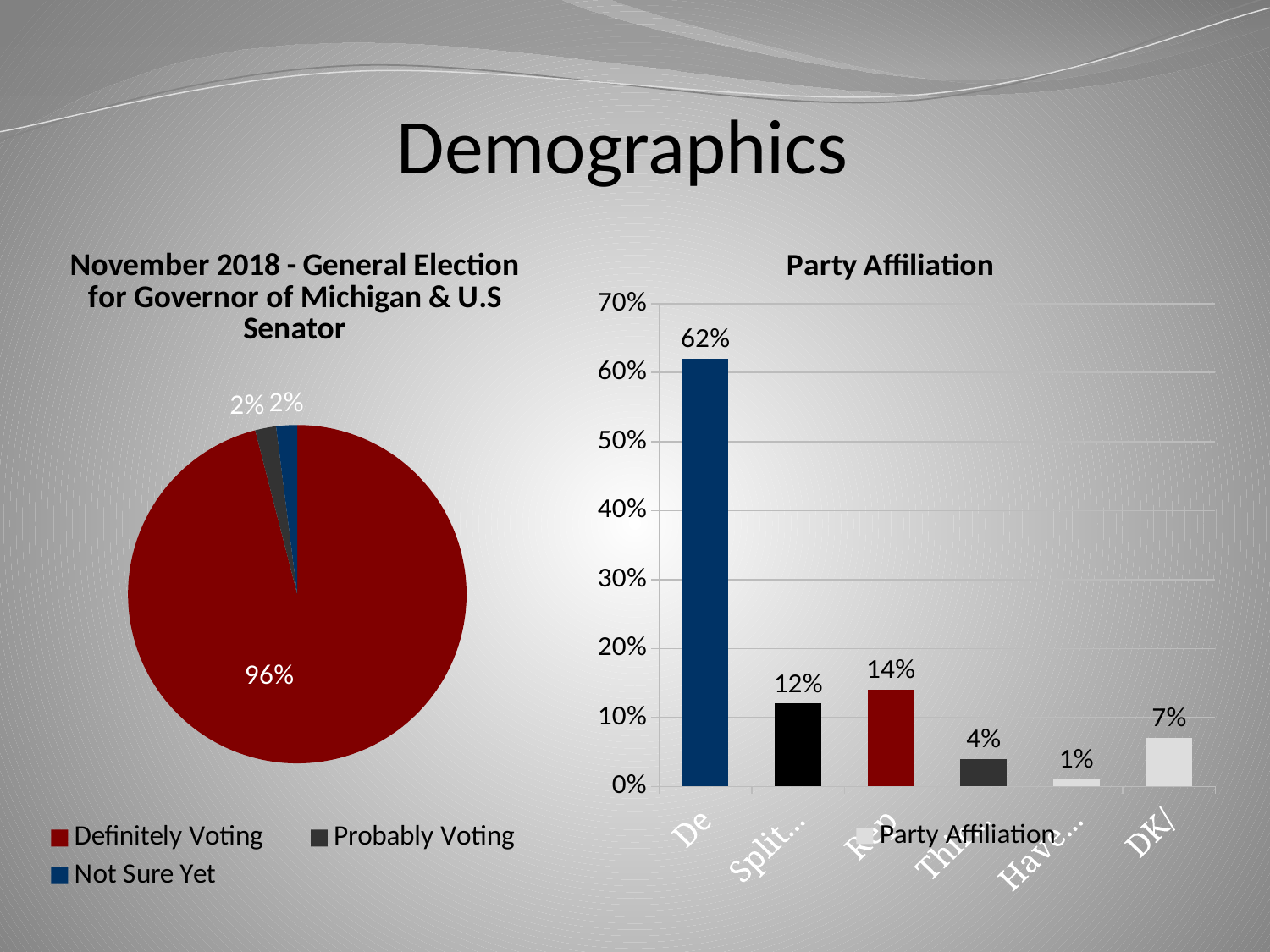
How many bars are plotted in the Party Affiliation chart? 6 In the Party Affiliation chart, what is the value of the shortest bar? 1% How many categories does the legend of the pie chart on the left list? 3 In the Party Affiliation chart, what is the difference between the highest and lowest bar values? 61% What kind of chart is the Party Affiliation chart? Bar chart In the pie chart on the left, what percentage is shown for Definitely Voting? 96% In the pie chart on the left, what is the difference between the Definitely Voting share and the Probably Voting share? 94% What kind of chart is the chart on the left of the slide? Pie chart In the pie chart on the left, which category has the largest slice? Definitely Voting In the Party Affiliation chart, what is the value of the tallest bar? 62% In the Party Affiliation chart, is the value of the first (leftmost) bar greater or less than 60%? greater In the pie chart on the left, what percentage is shown for Not Sure Yet? 2%